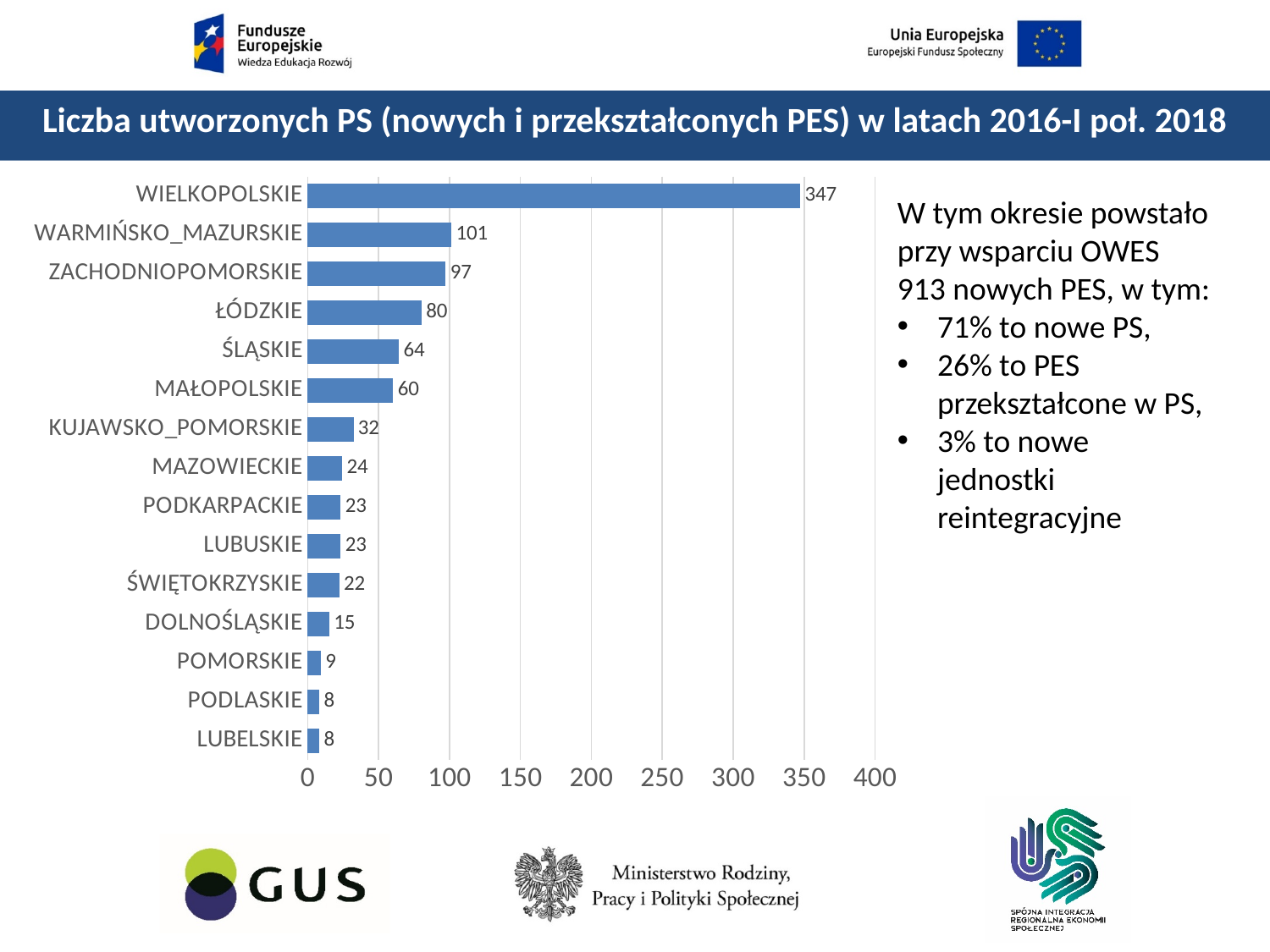
Which category has the highest value? WIELKOPOLSKIE Is the value for ZACHODNIOPOMORSKIE greater or less than 100? less What is the value for ŁÓDZKIE? 80 How many categories are shown on the chart? 15 What kind of chart is shown on the slide? bar chart What is the value for KUJAWSKO_POMORSKIE? 32 What is the difference between the values for WARMIŃSKO_MAZURSKIE and ZACHODNIOPOMORSKIE? 4 What is the title of the slide containing the chart? Liczba utworzonych PS (nowych i przekształconych PES) w latach 2016-I poł. 2018 What is the value for DOLNOŚLĄSKIE? 15 Which is larger, the value for ŚLĄSKIE or the value for MAŁOPOLSKIE? ŚLĄSKIE What is the difference between the values for WIELKOPOLSKIE and ŁÓDZKIE? 267 What is the value for WIELKOPOLSKIE? 347